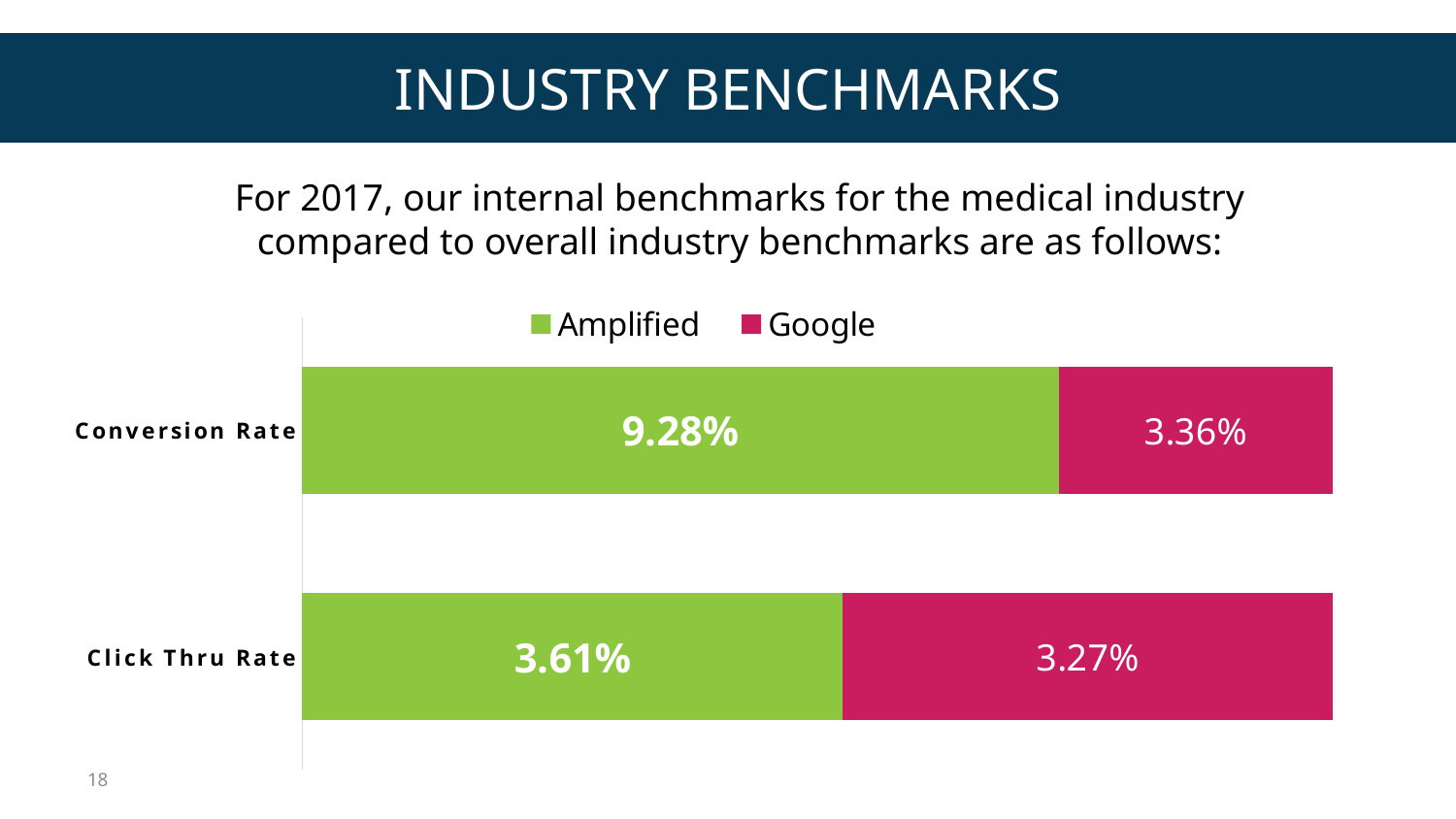
Which category has the lowest Google value? Click Thru Rate What is the Google value for Conversion Rate? 3.36% How many series does the legend list? 2 What is the difference between the Amplified and Google values for Conversion Rate? 5.92% Which category has the highest Amplified value? Conversion Rate What kind of chart is shown on the slide? bar chart How many categories are shown in the chart? 2 What is the difference between the Amplified and Google values for Click Thru Rate? 0.34% What is the Google value for Click Thru Rate? 3.27% For Conversion Rate, which series has the larger value, Amplified or Google? Amplified What is the Amplified value for Conversion Rate? 9.28% What is the Amplified value for Click Thru Rate? 3.61%